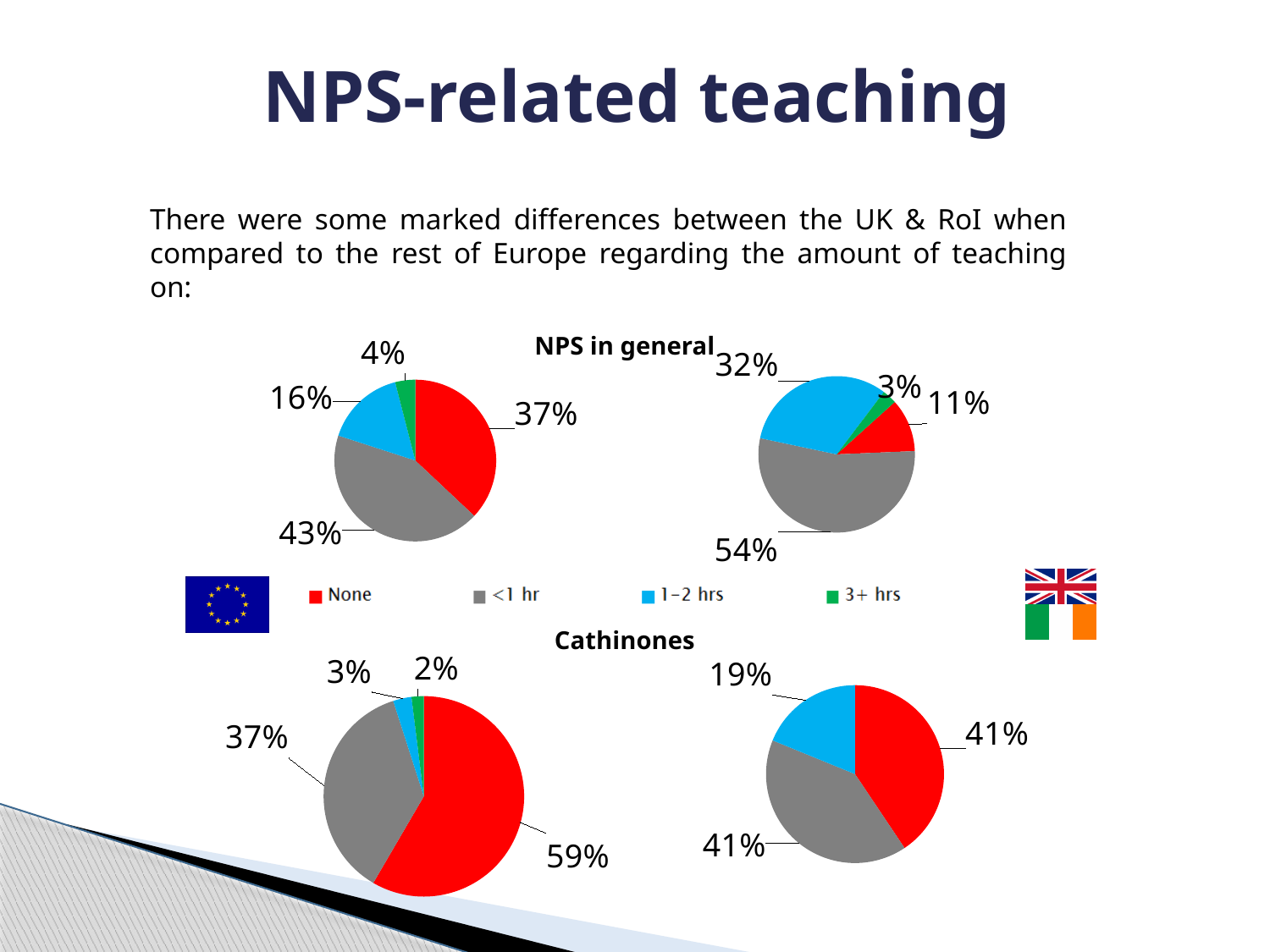
What is the difference between the 'None' share in the bottom-left Cathinones pie chart (59%) and the 'None' share in the bottom-right Cathinones pie chart (41%)? 18% In the top-right pie chart (NPS in general, UK & RoI side), what share is labelled for the '<1 hr' slice? 54% In the top-left pie chart (NPS in general, EU side), what share is labelled for the 'None' slice? 37% What type of charts are shown on the slide? Pie charts How many categories does the legend list? 4 In the top-left pie chart (NPS in general, EU side), what share is labelled for the '<1 hr' slice? 43% In the bottom-left pie chart (Cathinones, EU side), what share is labelled for the 'None' slice? 59% In the top-left pie chart (NPS in general, EU side), which category has the largest slice? <1 hr Which is larger: the '1-2 hrs' share in the top-left NPS in general pie chart or the '1-2 hrs' share in the top-right NPS in general pie chart? The top-right (32%) In the top-right pie chart (NPS in general, UK & RoI side), what share is labelled for the '1-2 hrs' slice? 32% In the bottom-left pie chart (Cathinones, EU side), which category has the smallest slice? 3+ hrs In the bottom-right pie chart (Cathinones, UK & RoI side), what share is labelled for the '1-2 hrs' slice? 19%